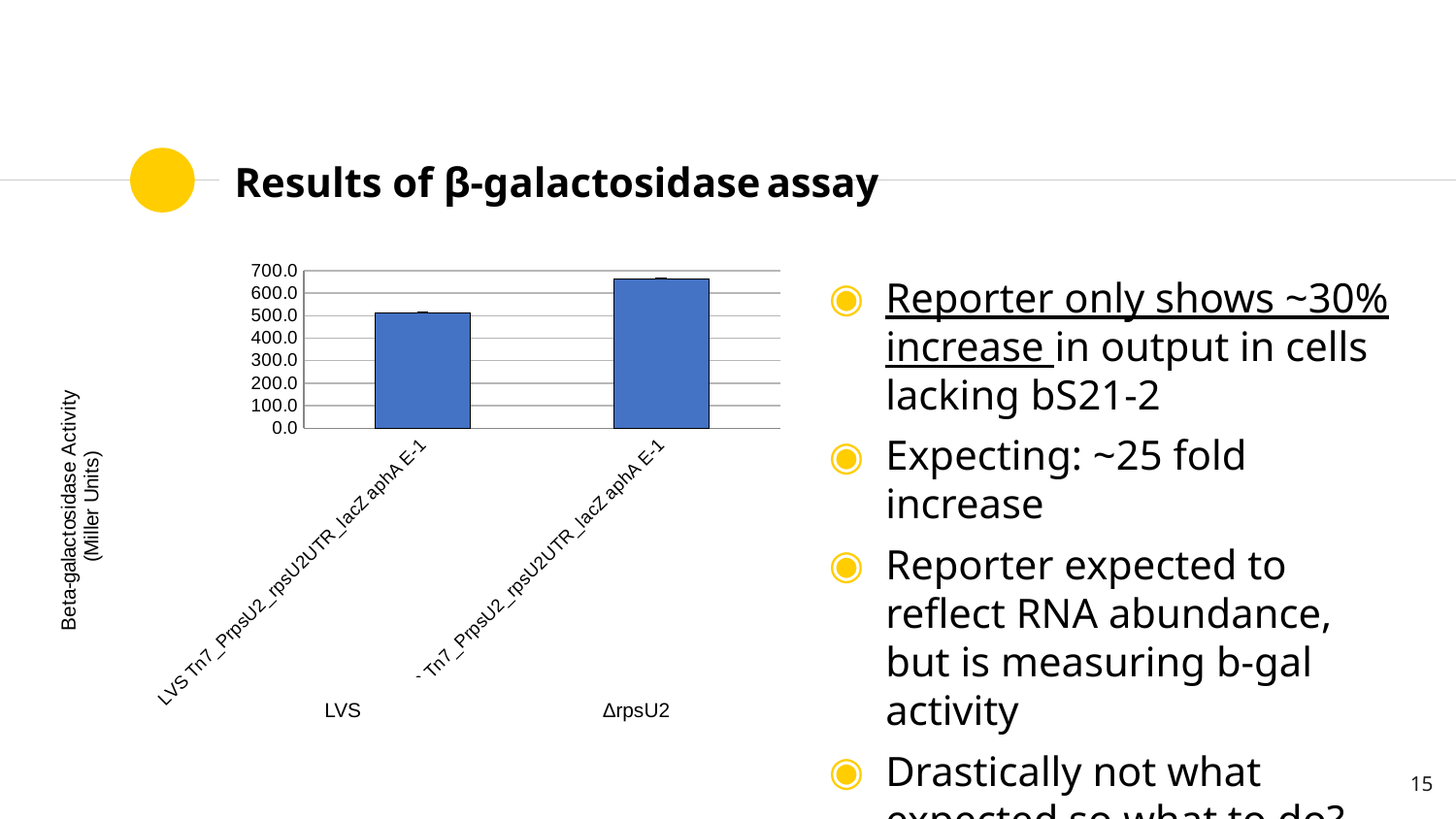
Which category has the highest beta-galactosidase activity? ΔrpsU2 What kind of chart is shown on the slide? bar chart Is the value for LVS greater or less than 600? less Which category has the lowest beta-galactosidase activity? LVS Is the value for ΔrpsU2 greater or less than 700? less Which is larger, the value for LVS or the value for ΔrpsU2? ΔrpsU2 Is the value for ΔrpsU2 greater or less than 600? greater How many bars are plotted in the chart? 2 What is the highest tick value shown on the y axis? 700.0 What is the label of the y axis of the chart? Beta-galactosidase Activity (Miller Units) Do the values rise or fall from LVS to ΔrpsU2 along the x axis? rise